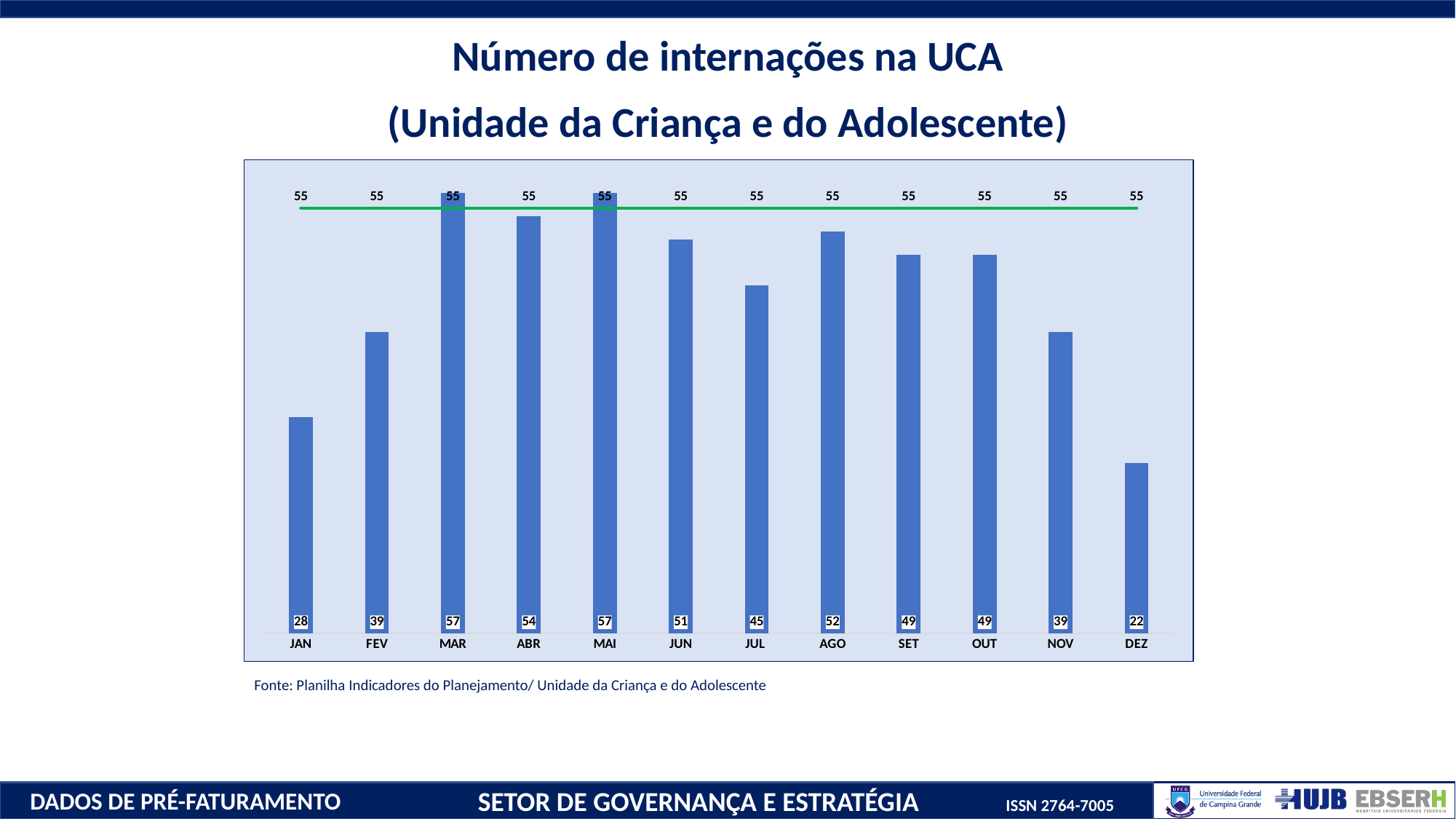
What is the value of the bar for AGO? 52 Which is larger, the value for FEV or the value for JUL? JUL What kind of chart is shown on the slide? bar chart What is the value of the bar for DEZ? 22 What is the number of internações in JAN? 28 What is the difference between the values for MAR and JAN? 29 What constant value does the green line across the chart represent? 55 Do the bar values rise or fall from SET to DEZ? fall Which is larger, the value for ABR or the value for NOV? ABR Which month has the lowest number of internações? DEZ How many months are shown on the x axis? 12 What is the difference between the values for JUN and JUL? 6